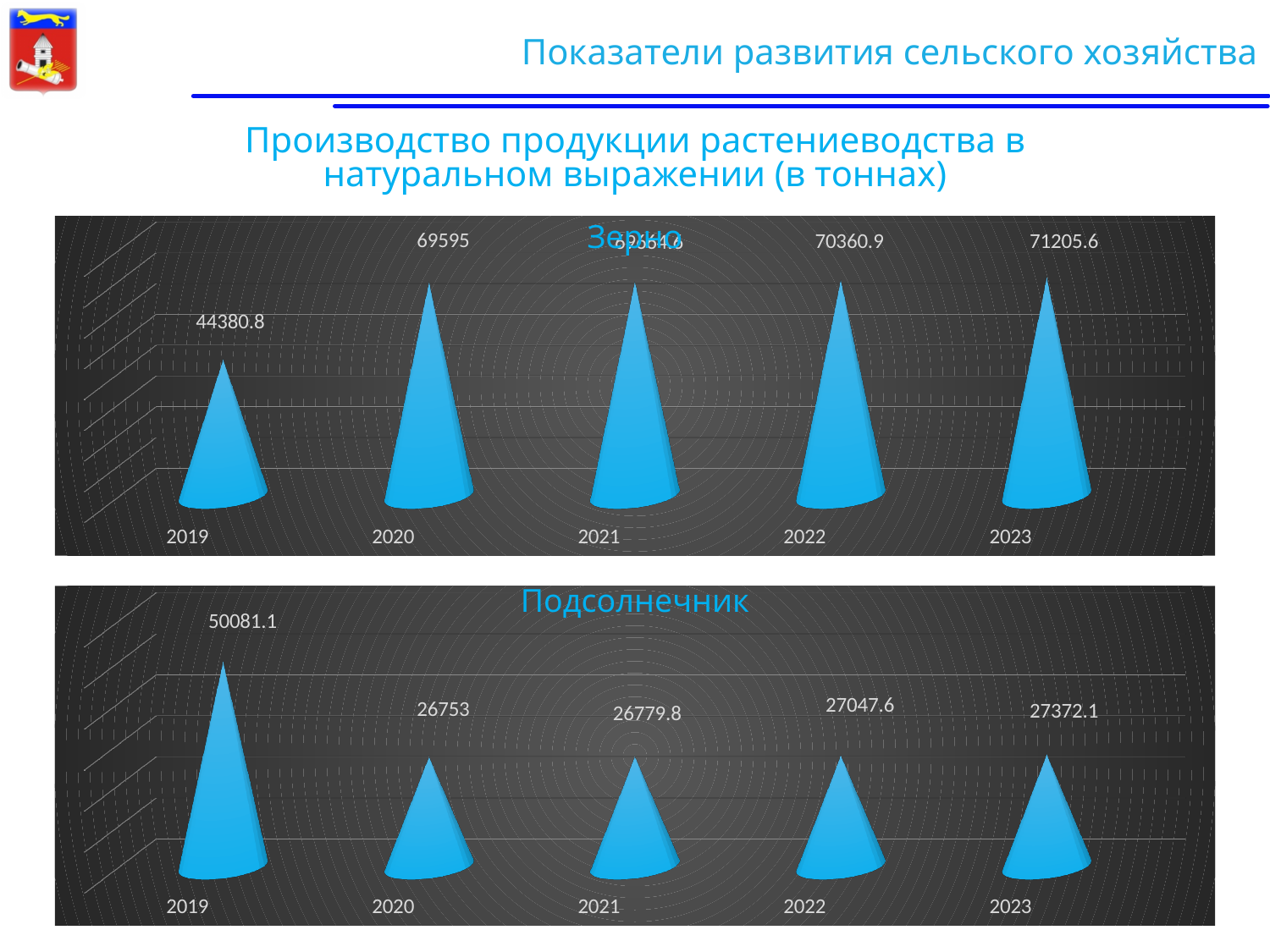
In the Подсолнечник chart, what is the value for 2021? 26779.8 In the Зерно chart, which is larger, the value for 2020 or the value for 2019? 2020 In the Зерно chart, what is the difference between the values for 2023 and 2019? 26824.8 How many years are shown in the Подсолнечник chart? 5 In the Зерно chart, what is the value for 2022? 70360.9 In the Подсолнечник chart, what is the value for 2019? 50081.1 In the Подсолнечник chart, which year has the highest value? 2019 In the Подсолнечник chart, what is the difference between the values for 2019 and 2023? 22709 In the Зерно chart, what is the value for 2023? 71205.6 What kind of chart is the Подсолнечник chart? Bar chart In the Зерно chart, what is the value for 2019? 44380.8 In the Зерно chart, which year has the lowest value? 2019